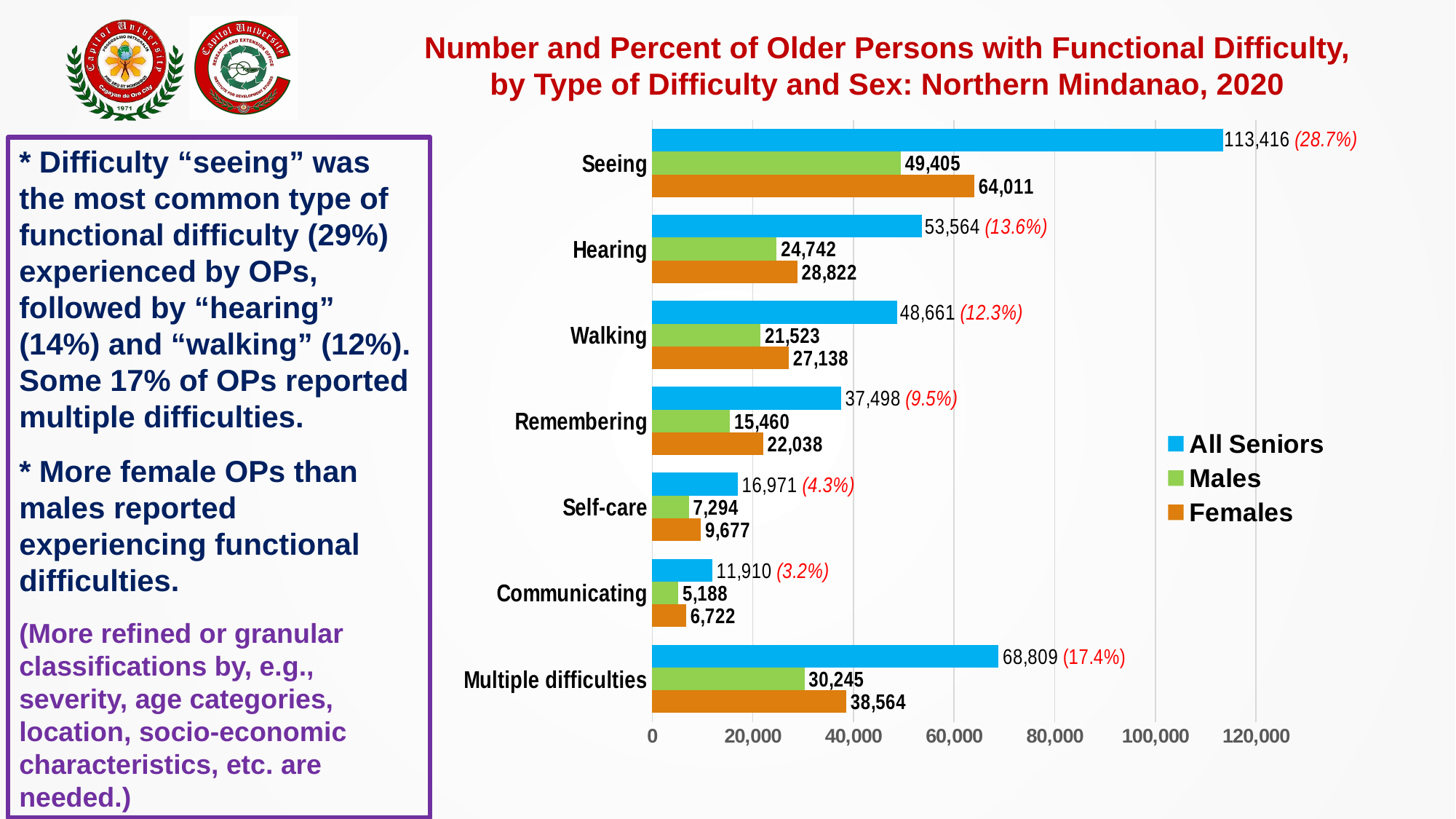
How many types of difficulty are shown on the chart? 7 Which is larger for Remembering, the Males value or the Females value? Females What is the Females value for Hearing? 28,822 Which type of difficulty has the lowest Males value? Communicating Is the All Seniors value for Hearing greater or less than 60,000? less What is the All Seniors value for Seeing? 113,416 What percent is shown next to the All Seniors bar for Multiple difficulties? 17.4% How many series does the legend list? 3 What is the difference between the Females and Males values for Seeing? 14,606 Which type of difficulty has the highest All Seniors value? Seeing What kind of chart is shown on the slide? bar chart What is the Males value for Walking? 21,523